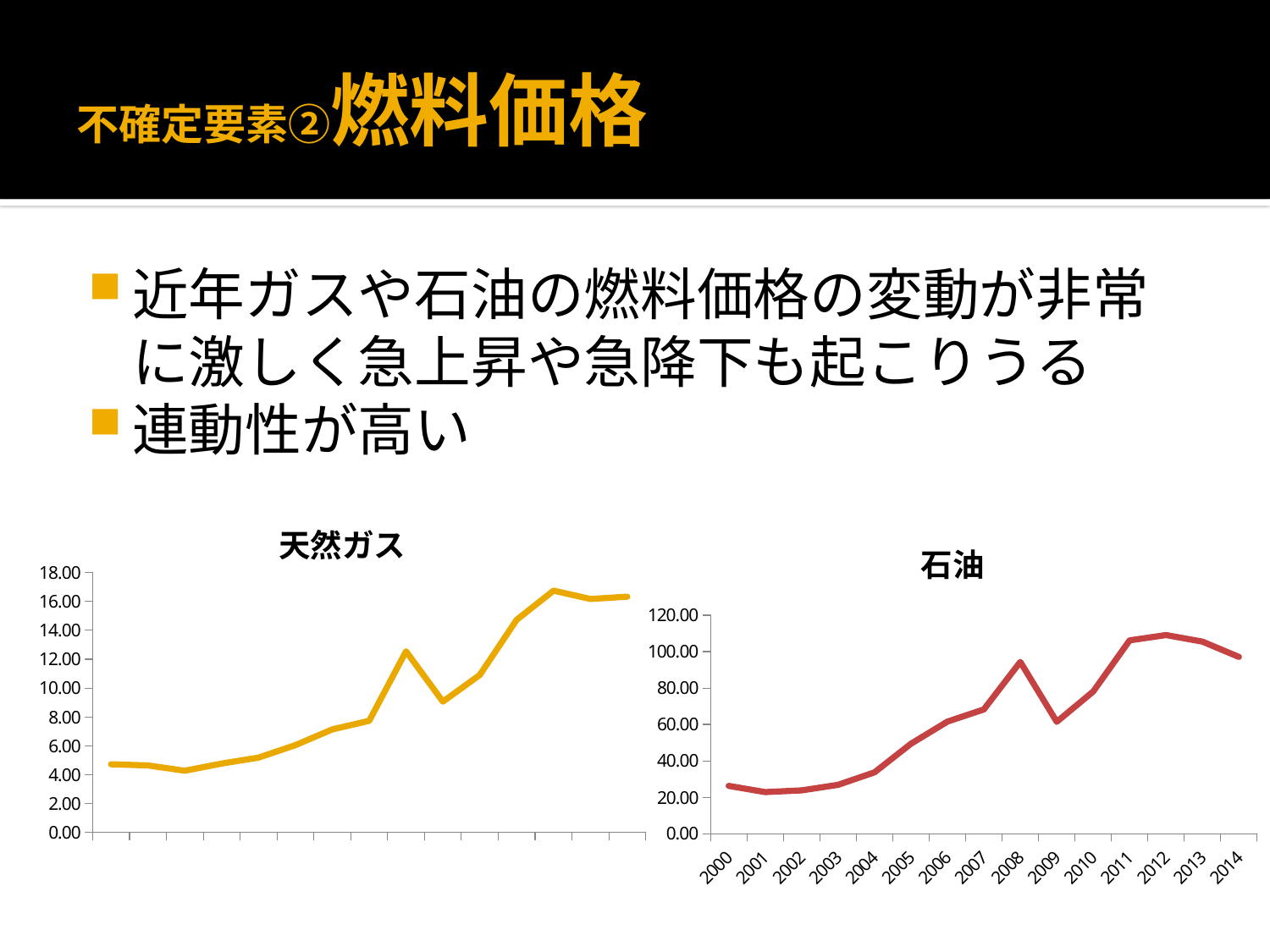
On the 石油 chart, is the value for 2005 greater or less than 40? greater On the 石油 chart, which year has the larger value, 2008 or 2009? 2008 On the 石油 chart, which year has the larger value, 2010 or 2011? 2011 How many years are plotted on the 石油 chart? 15 On the 天然ガス chart, is the highest point on the line greater or less than 14.00? greater On the 石油 chart, is the value for 2009 greater or less than 80? less On the 石油 chart, do values overall rise or fall from 2000 to 2014? rise What is the title of the chart on the left of the slide? 天然ガス What type of chart is the 石油 chart? line chart